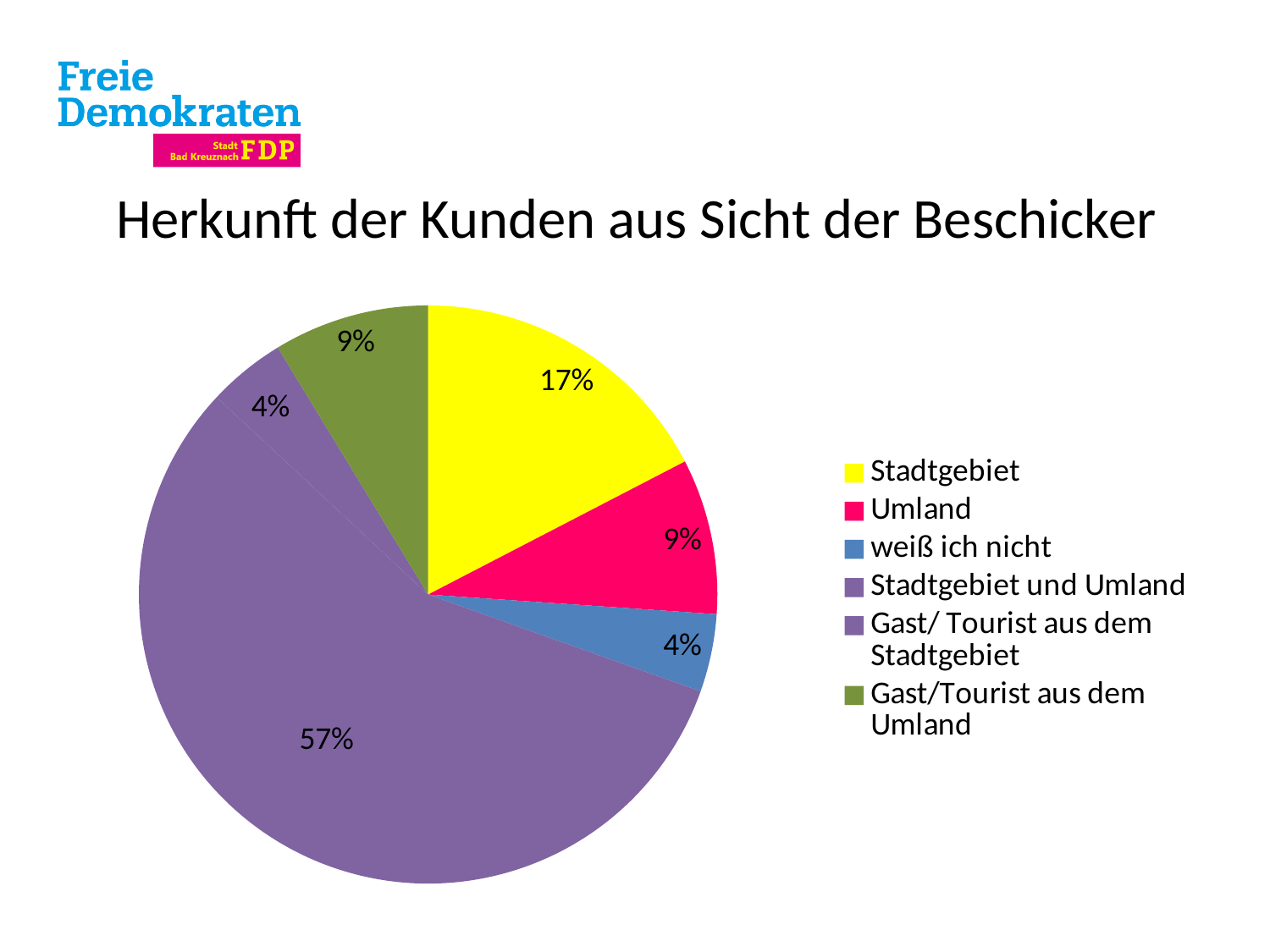
What is the difference between the share for Stadtgebiet und Umland and the share for Stadtgebiet? 40% What share of the pie is Umland? 9% Which colour represents Stadtgebiet in the legend? yellow What share of the pie is Stadtgebiet und Umland? 57% What is the title of the chart? Herkunft der Kunden aus Sicht der Beschicker What share of the pie is weiß ich nicht? 4% What kind of chart is shown on the slide? pie chart Which is larger, the share for Stadtgebiet or the share for Umland? Stadtgebiet How many categories does the legend list? 6 Which category has the largest share of the pie? Stadtgebiet und Umland